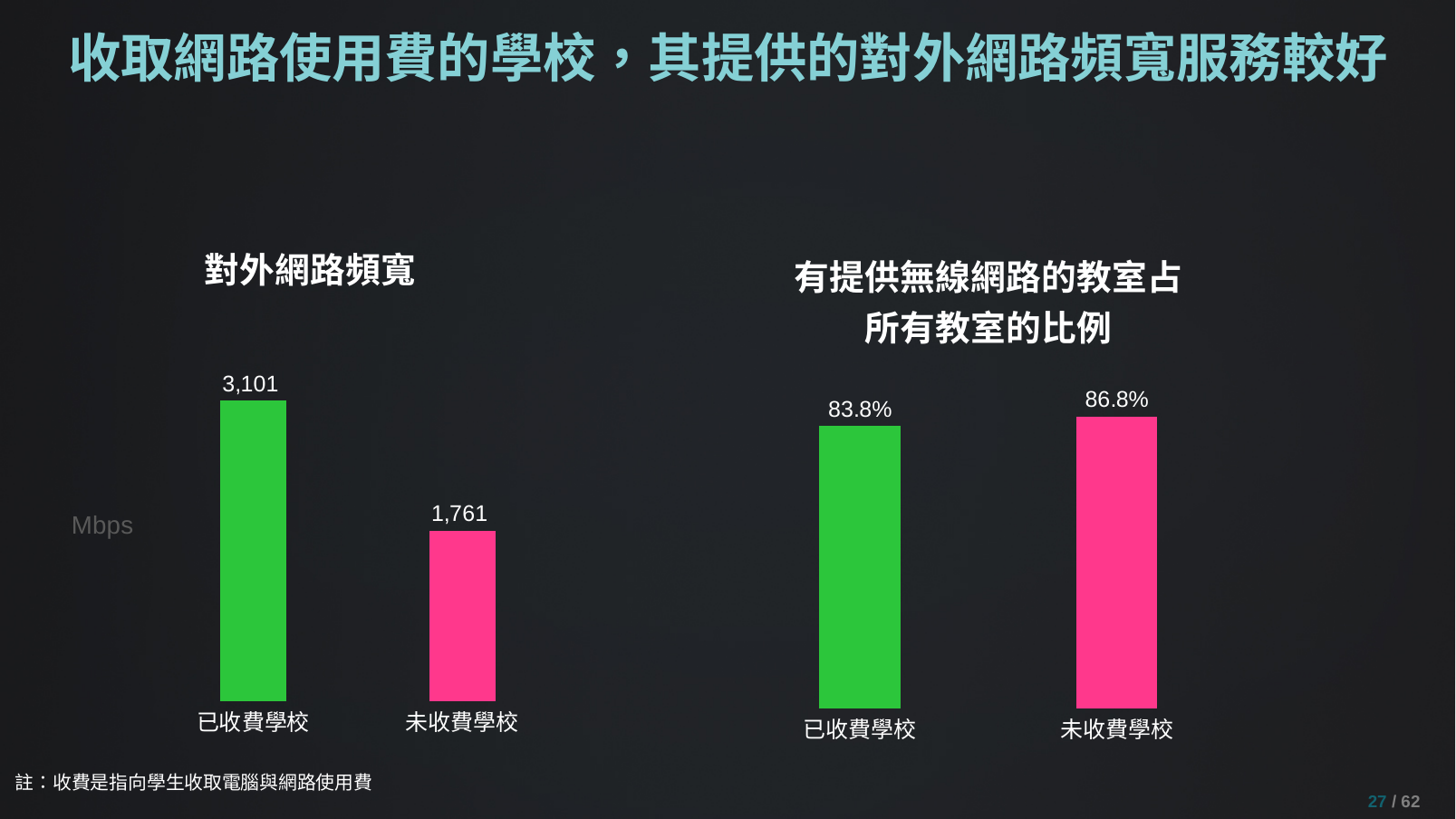
In the right chart titled 有提供無線網路的教室占所有教室的比例, what is the difference between 未收費學校 and 已收費學校? 3.0% In the left chart titled 對外網路頻寬, which category has the higher value? 已收費學校 In the right chart titled 有提供無線網路的教室占所有教室的比例, what is the value for 已收費學校? 83.8% In the right chart titled 有提供無線網路的教室占所有教室的比例, what is the value for 未收費學校? 86.8% In the left chart titled 對外網路頻寬, what is the difference between 已收費學校 and 未收費學校? 1,340 In the left chart titled 對外網路頻寬, what colour is the bar for 未收費學校? Pink In the left chart titled 對外網路頻寬, what unit is shown on the axis label? Mbps In the right chart titled 有提供無線網路的教室占所有教室的比例, which category has the lower value? 已收費學校 In the left chart titled 對外網路頻寬, what is the value for 未收費學校? 1,761 What kind of chart is the left chart titled 對外網路頻寬? Bar chart In the right chart titled 有提供無線網路的教室占所有教室的比例, how many categories are shown? 2 In the left chart titled 對外網路頻寬, what is the value for 已收費學校? 3,101